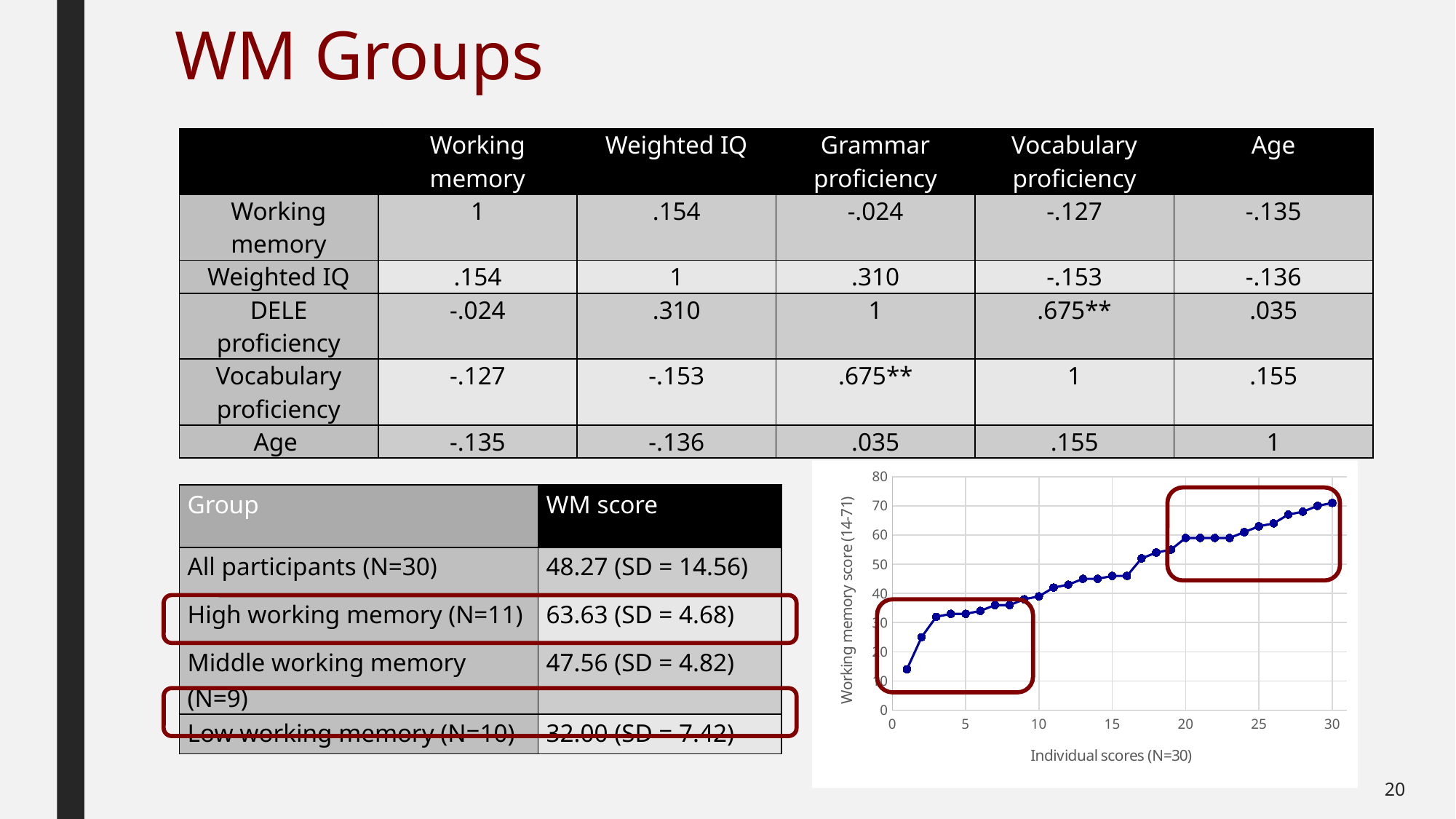
Is the working memory score for individual 20 greater or less than 50? greater What kind of chart is shown on the slide? line chart How many individual scores are plotted on the chart? 30 Is the working memory score for individual 5 greater or less than 40? less Is the working memory score for individual 1 greater or less than 20? less Do the working memory scores rise or fall as the individual number increases along the x axis? rise Which individual has the lowest working memory score on the chart? 1 Which individual has the highest working memory score on the chart? 30 What is the title of the vertical axis of the chart? Working memory score (14-71) What is the title of the horizontal axis of the chart? Individual scores (N=30) Which individual has the larger working memory score, individual 10 or individual 20? individual 20